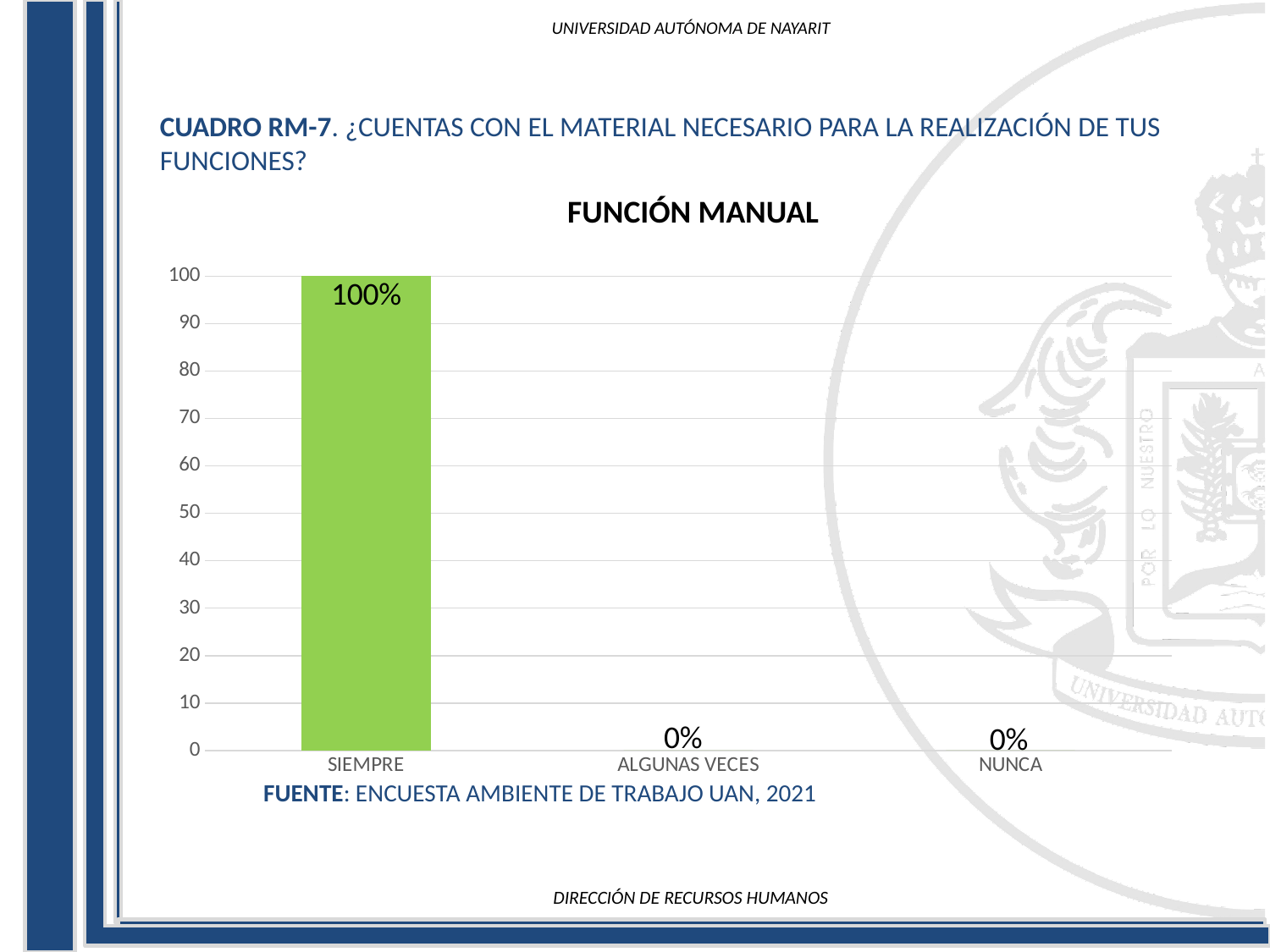
Which category has the highest value? SIEMPRE What is the value for ALGUNAS VECES? 0% Do the values rise or fall from SIEMPRE to NUNCA? fall What is the value for SIEMPRE? 100% What kind of chart is shown? bar chart What is the difference between the values for SIEMPRE and NUNCA? 100% Is the value for SIEMPRE greater or less than 50? greater What is the value for NUNCA? 0% What colour is the bar for SIEMPRE? green Which is larger, the value for SIEMPRE or the value for ALGUNAS VECES? SIEMPRE How many categories are shown on the x axis? 3 What is the title of the chart? FUNCIÓN MANUAL